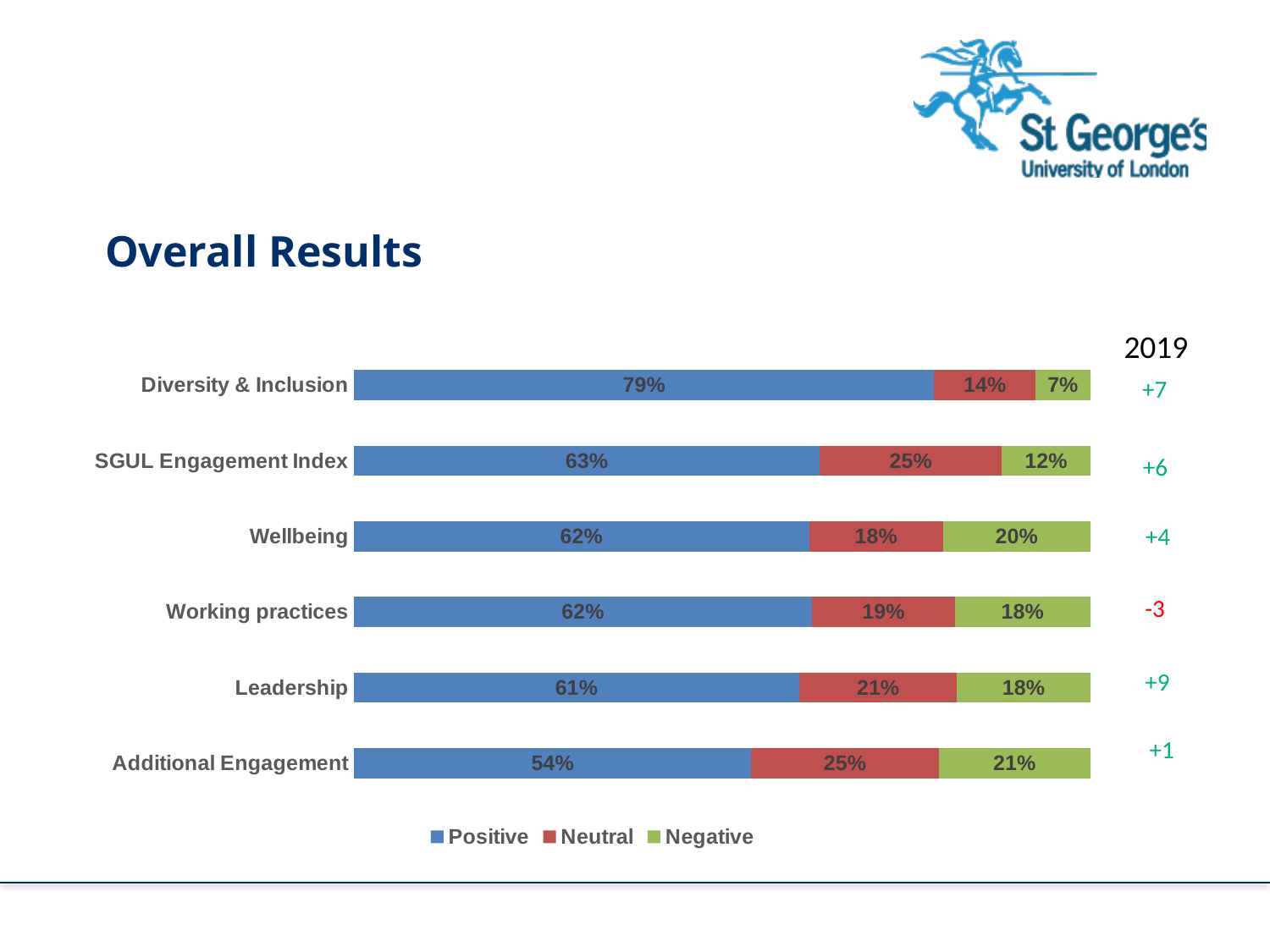
How many series does the legend list? 3 What is the Positive value for Diversity & Inclusion? 79% What kind of chart is shown on the slide? Stacked bar chart What is the Neutral value for SGUL Engagement Index? 25% Which category has the lowest Negative value? Diversity & Inclusion What is the difference between the Positive values for Diversity & Inclusion and Additional Engagement? 25% What is the Positive value for Additional Engagement? 54% What is the Negative value for Wellbeing? 20% Which is larger, the Negative value for Wellbeing or the Negative value for Working practices? Wellbeing How many categories are shown in the chart? 6 Which category has the highest Positive value? Diversity & Inclusion What is the total of the stacked bar for Leadership? 100%